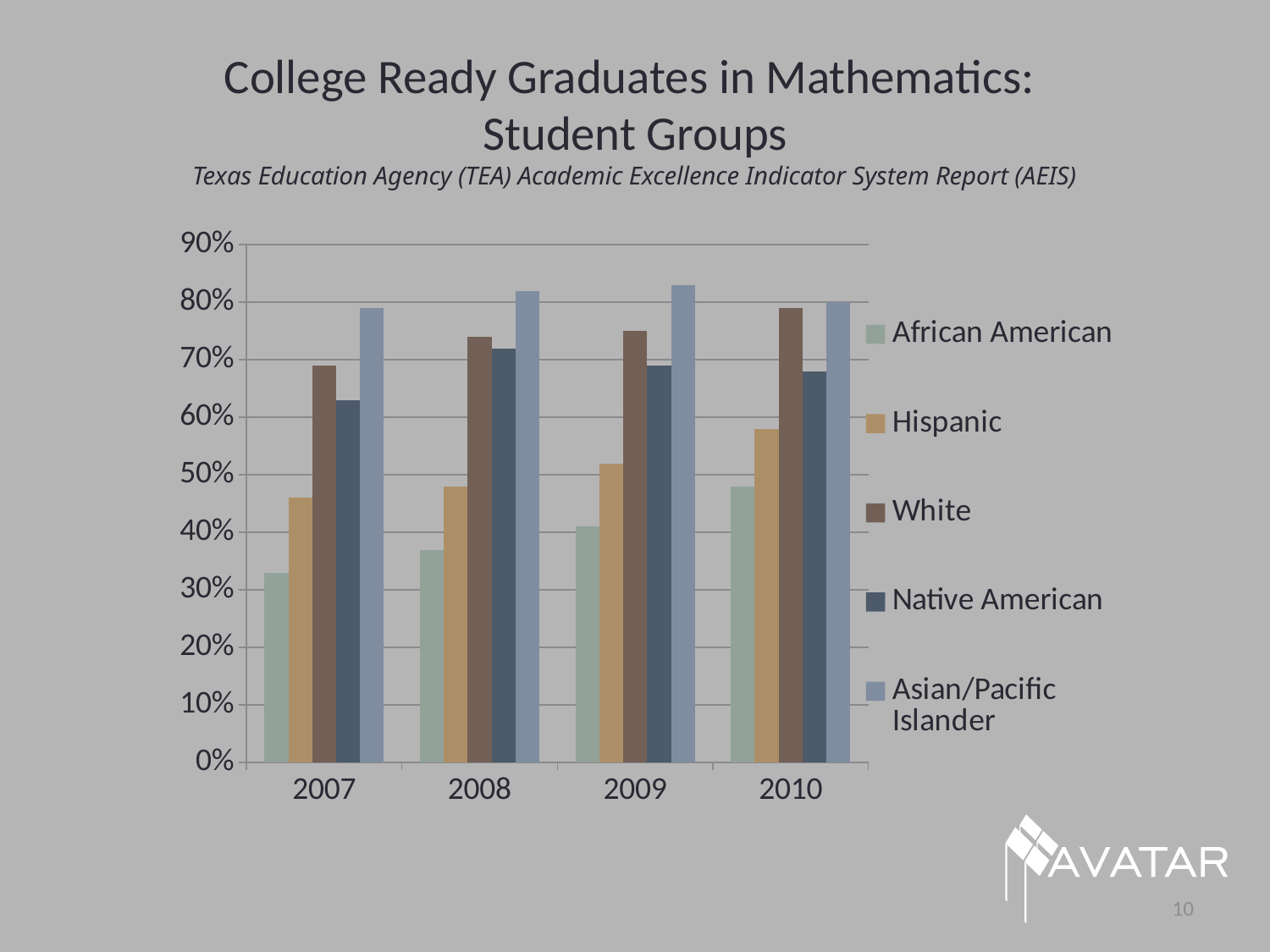
Which student group has the lowest value in 2010? African American Is the value for Asian/Pacific Islander in 2009 greater or less than 80%? greater How many student groups does the legend list? 5 Is the value for African American in 2007 greater or less than 40%? less How many years are shown on the x axis of the chart? 4 What kind of chart is shown on the slide? bar chart In 2007, which is larger: the value for White or the value for Native American? White Do the values for African American rise or fall from 2007 to 2010? rise Which student group has the highest value in 2007? Asian/Pacific Islander What is the title of the chart on the slide? College Ready Graduates in Mathematics: Student Groups Is the value for Hispanic in 2010 greater or less than 50%? greater Which student group is shown in light green in the legend? African American